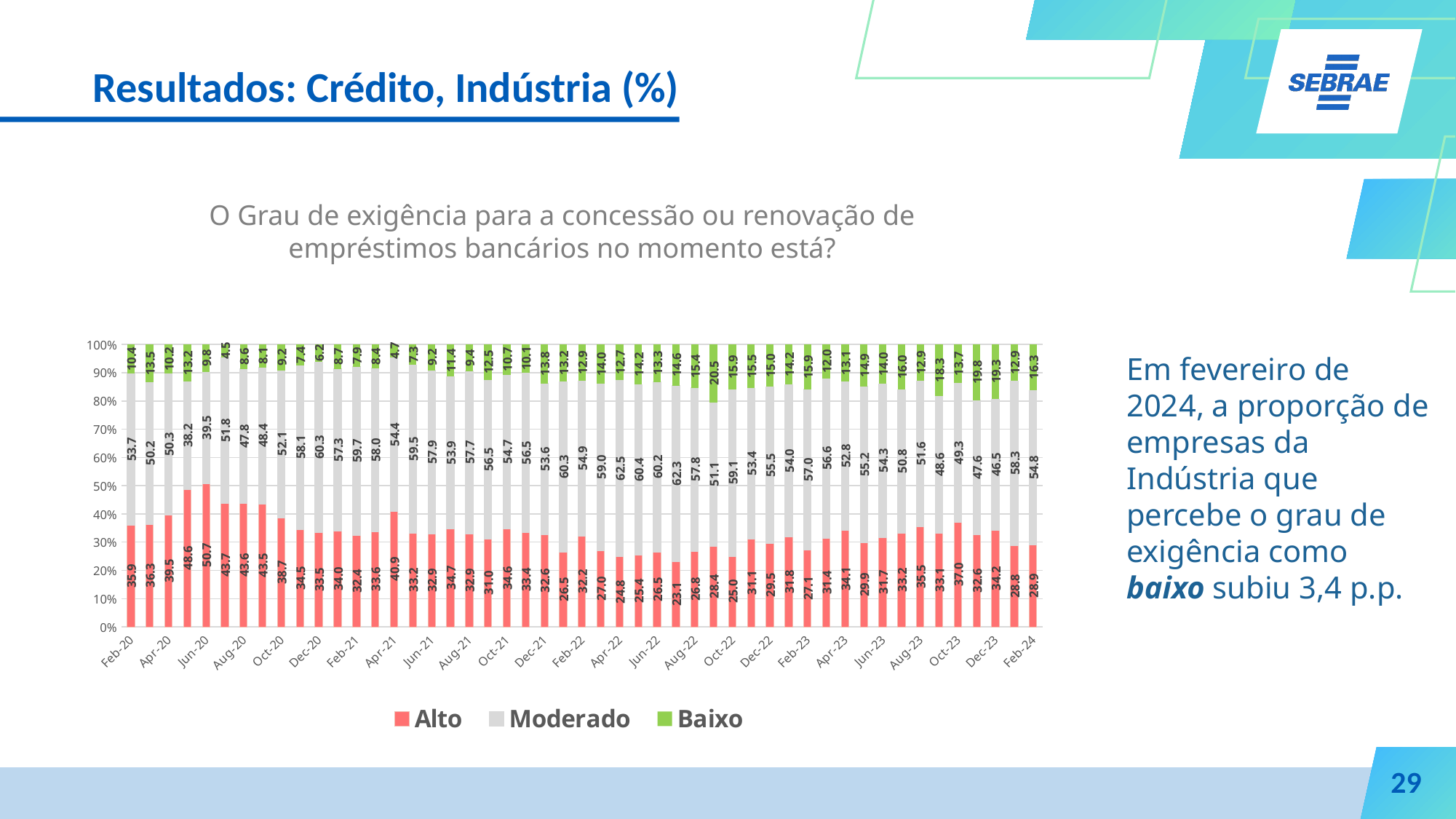
What type of chart is shown on the slide? Stacked bar chart What is the difference between the Alto value for Feb-20 and the Alto value for Feb-24? 7.0 What is the value of Alto for Feb-20? 35.9 What is the value of Alto for Feb-24? 28.9 Which month has the highest Alto value? Jun-20 What are the three series listed in the legend? Alto, Moderado, Baixo How many series does the legend list? 3 Is the Baixo value for Feb-24 greater or less than 20%? less What is the highest value shown for Baixo? 20.5 In Jun-20, which is larger: Alto or Moderado? Alto What is the value of Moderado for Jun-20? 39.5 What is the value of Baixo for Feb-24? 16.3